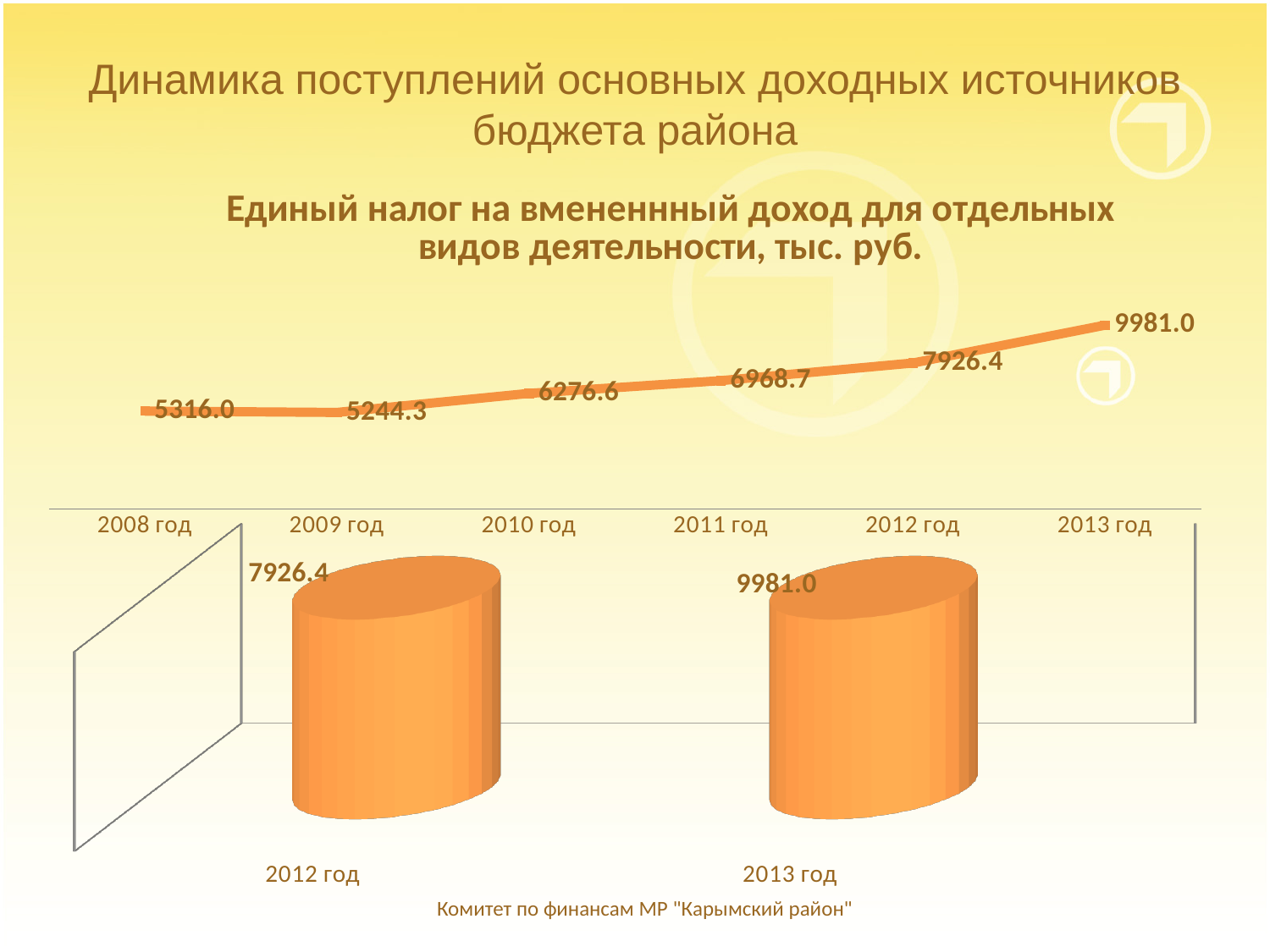
In the bottom bar chart, what is the value for 2012 год? 7926.4 In the top line chart, which is larger: the value for 2011 год or the value for 2010 год? 2011 год How many data points are plotted in the top line chart? 6 In the top line chart, what is the difference between the values for 2013 год and 2012 год? 2054.6 In the top line chart, which year has the highest value? 2013 год What kind of chart is the top chart on the slide? line chart In the bottom bar chart, what is the difference between the values for 2013 год and 2012 год? 2054.6 In the top line chart, do the values generally rise or fall from 2009 год to 2013 год? rise In the top line chart, what is the value for 2010 год? 6276.6 What is the title of the top line chart? Единый налог на вмененнный доход для отдельных видов деятельности, тыс. руб. In the top line chart, which year has the lowest value? 2009 год In the top line chart, what is the value for 2008 год? 5316.0